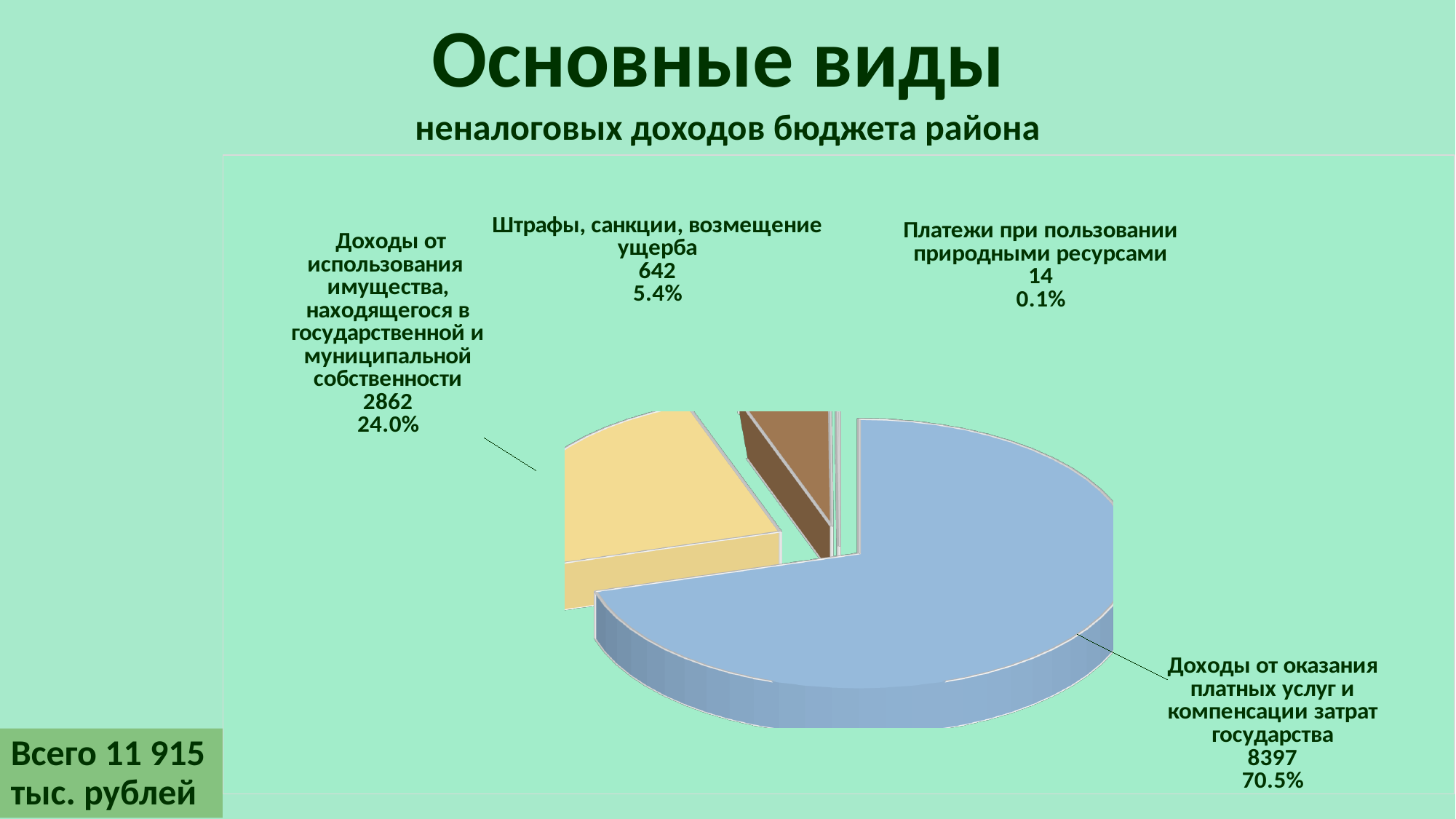
What value is shown for «Доходы от оказания платных услуг и компенсации затрат государства»? 8397 How many categories are shown in the pie chart? 4 What value is shown for «Штрафы, санкции, возмещение ущерба»? 642 Which category has the largest slice of the pie? Доходы от оказания платных услуг и компенсации затрат государства Which is larger: the value for «Штрафы, санкции, возмещение ущерба» or for «Платежи при пользовании природными ресурсами»? Штрафы, санкции, возмещение ущерба What value is shown for «Платежи при пользовании природными ресурсами»? 14 Which category has the smallest slice of the pie? Платежи при пользовании природными ресурсами What percentage share is shown for «Доходы от использования имущества, находящегося в государственной и муниципальной собственности»? 24.0% What percentage share is shown for «Доходы от оказания платных услуг и компенсации затрат государства»? 70.5% What is the difference between the values for «Доходы от оказания платных услуг и компенсации затрат государства» and «Доходы от использования имущества, находящегося в государственной и муниципальной собственности»? 5535 What total amount is stated on the slide for all non-tax revenues? 11 915 тыс. рублей What type of chart is shown on the slide? Pie chart